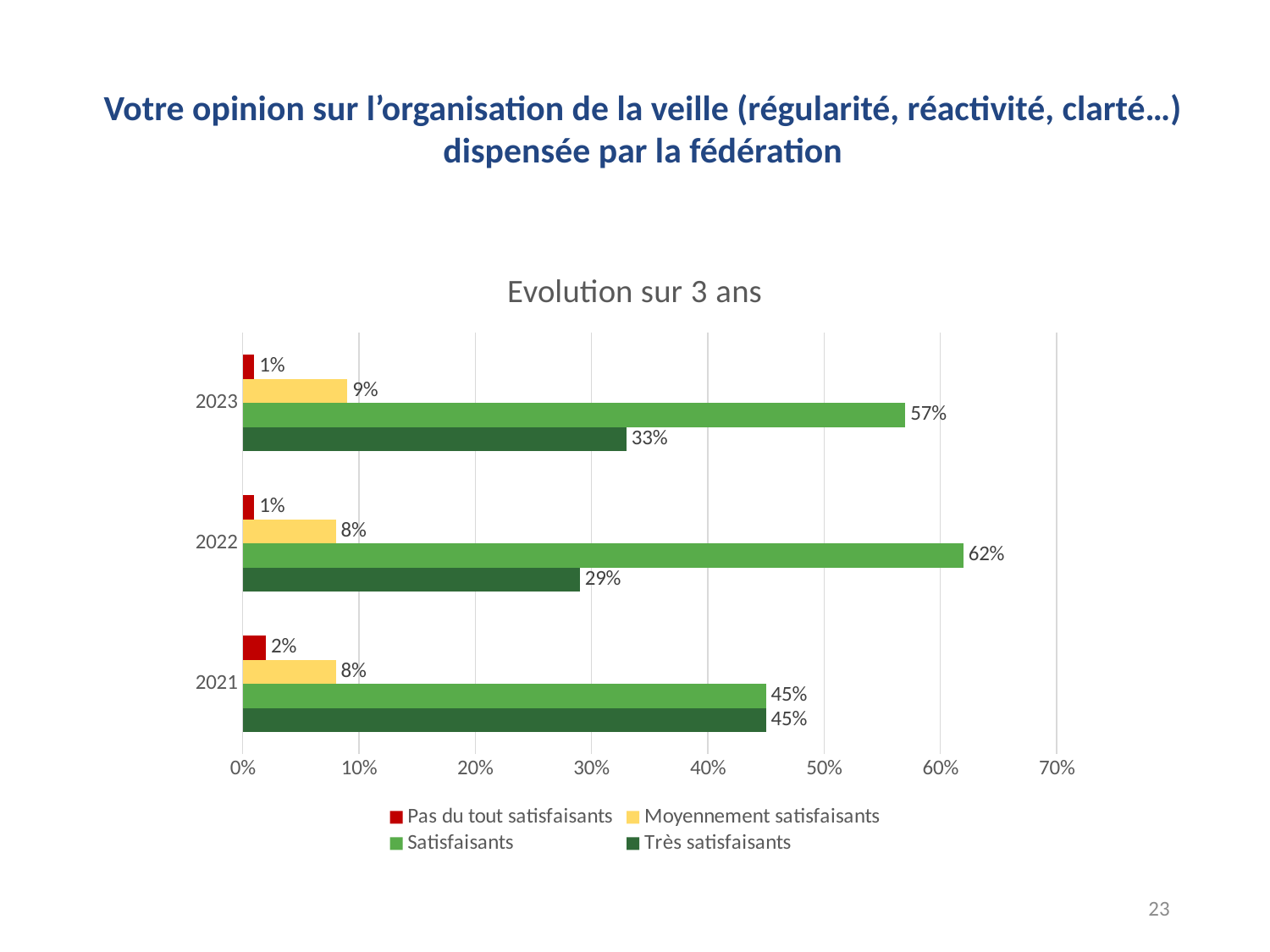
What is the value for "Moyennement satisfaisants" in 2023? 9% In which year is the "Satisfaisants" value highest? 2022 What kind of chart is shown? Bar chart In which year is the "Très satisfaisants" value lowest? 2022 What is the value for "Très satisfaisants" in 2022? 29% What is the value for "Pas du tout satisfaisants" in 2021? 2% What is the difference between the "Satisfaisants" values for 2022 and 2023? 5% How many series does the legend list? 4 What is the value for "Satisfaisants" in 2023? 57% Which is larger in 2023: "Satisfaisants" or "Très satisfaisants"? Satisfaisants What is the title of the chart? Evolution sur 3 ans How many years are shown on the chart? 3